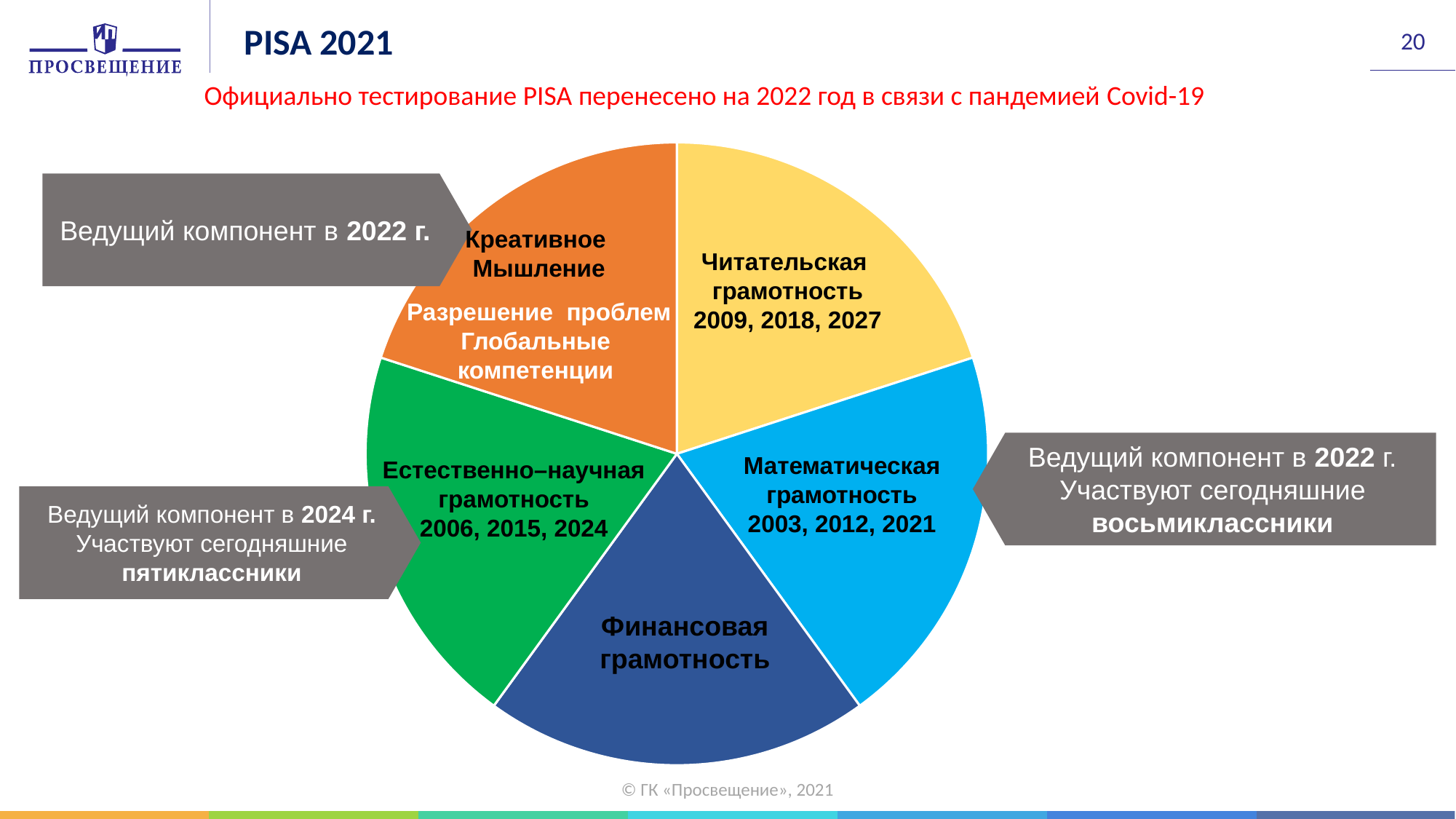
Which years are listed on the Математическая грамотность slice of the pie chart? 2003, 2012, 2021 How many slices does the pie chart have? 5 Which years are listed on the Естественно–научная грамотность slice of the pie chart? 2006, 2015, 2024 What kind of chart is shown on the slide? pie chart Which years are listed on the Читательская грамотность slice of the pie chart? 2009, 2018, 2027 Which slice of the pie chart is coloured orange? Креативное мышление / Разрешение проблем / Глобальные компетенции What colour is the Финансовая грамотность slice of the pie chart? dark blue